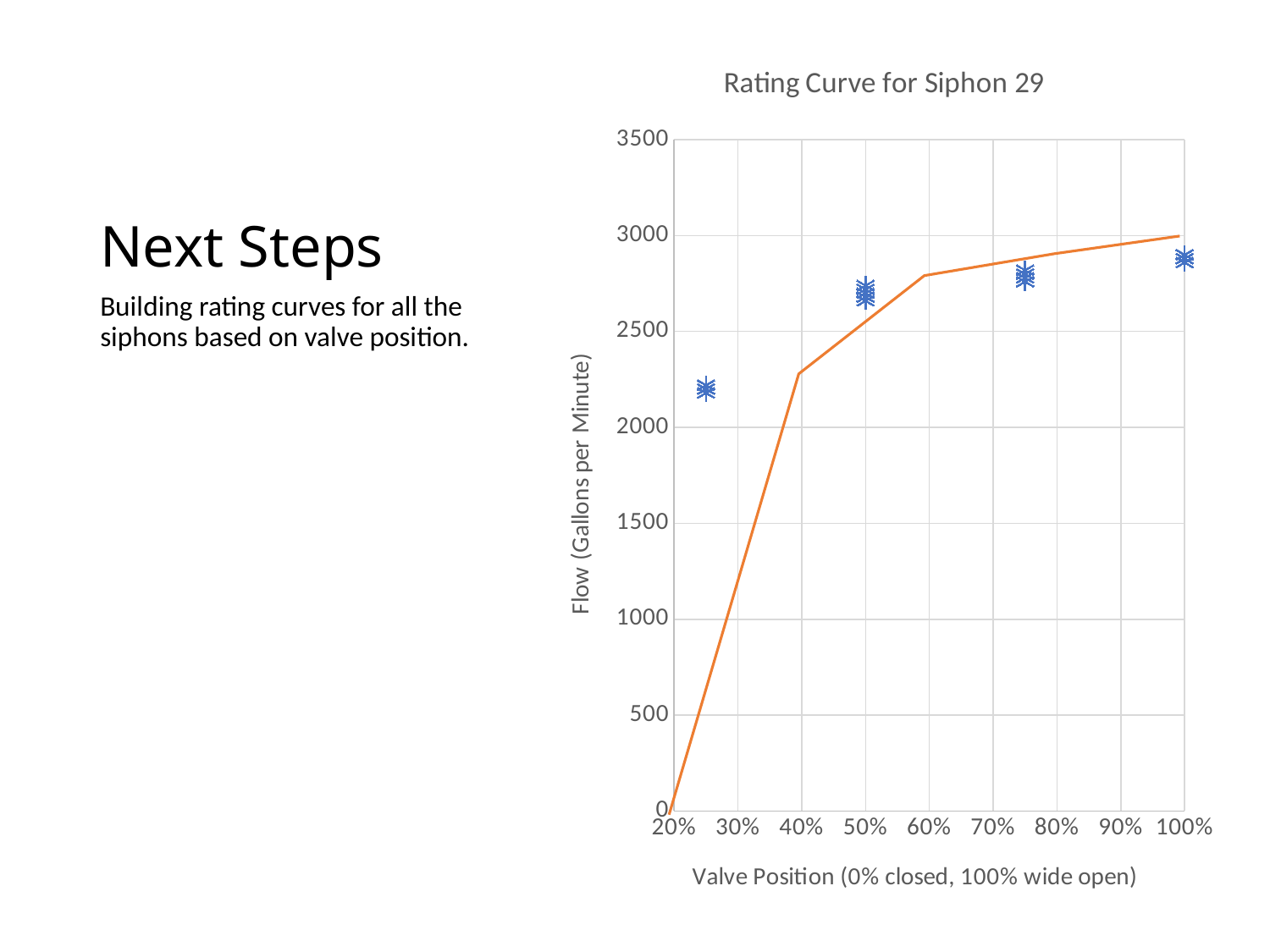
What is the title of the chart? Rating Curve for Siphon 29 Which has the higher measured flow: 25% valve position or 100% valve position? 100% valve position Does flow rise or fall as valve position increases from 20% to 100%? rises Is the measured flow at 50% valve position greater or less than 2500 gallons per minute? greater What kind of chart is shown on the slide? Scatter chart with a fitted line Is the measured flow at 100% valve position greater or less than 3000 gallons per minute? less What flow value does the orange line show at 20% valve position? 0 Is the measured flow at 25% valve position greater or less than 2000 gallons per minute? greater At how many distinct valve positions are measured data points plotted? 4 What is the label of the vertical axis? Flow (Gallons per Minute)